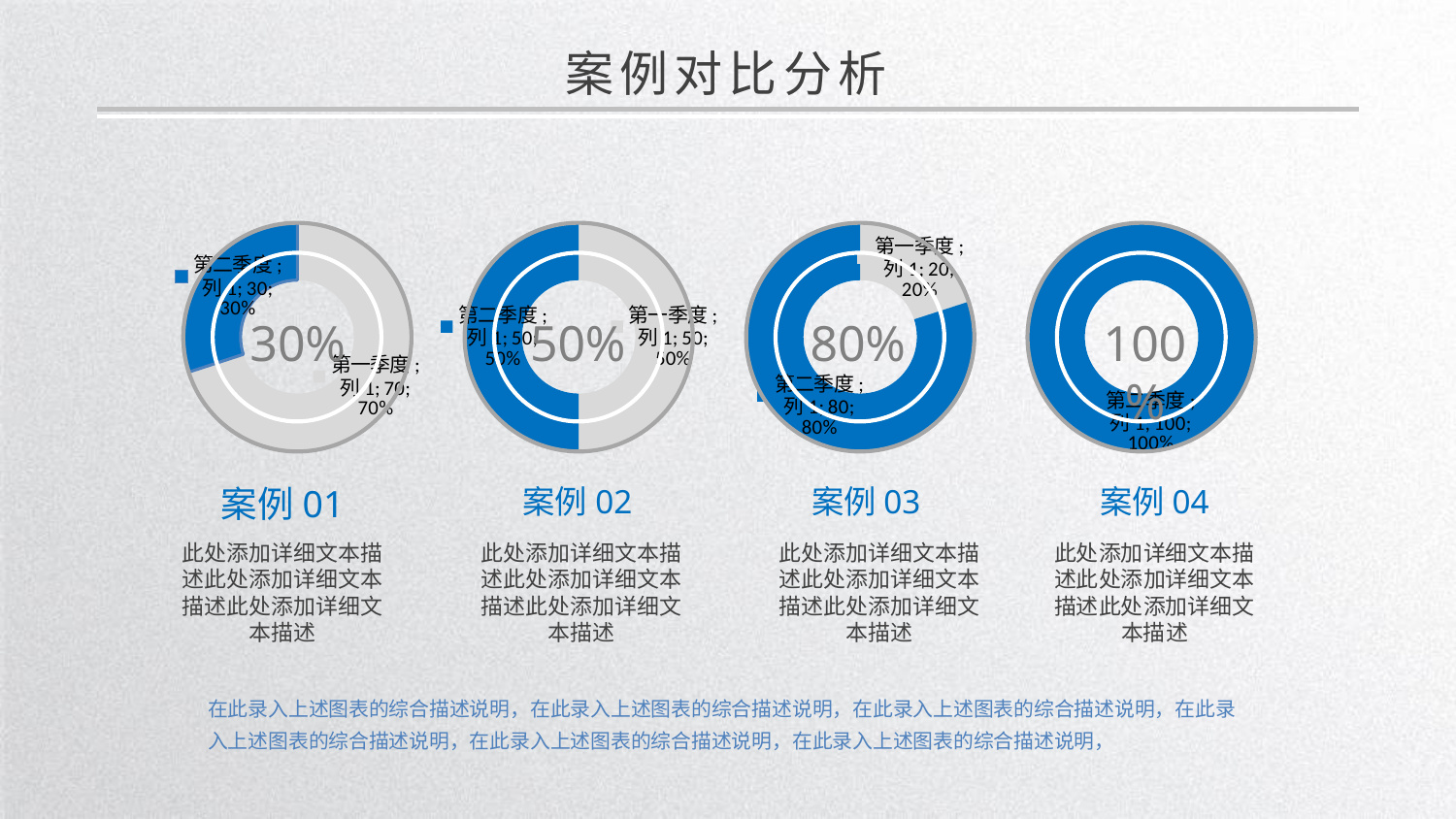
In the 案例 02 chart, what percentage share does 第二季度 have? 50% In the 案例 03 chart, which category has the highest value? 第二季度 In the 案例 03 chart, what is the difference between the 第二季度 and 第一季度 values? 60 In the 案例 01 chart, what percentage share does 第一季度 have? 70% In the 案例 01 chart, what is the value for 第二季度? 30 In the 案例 02 chart, what is the value for 第一季度? 50 In the 案例 01 chart, what is the difference between the 第一季度 and 第二季度 values? 40 What kind of chart is used for 案例 01? doughnut chart In the 案例 03 chart, what is the value for 第一季度? 20 How many doughnut charts are shown on the slide? 4 In the 案例 01 chart, which category is larger, 第一季度 or 第二季度? 第一季度